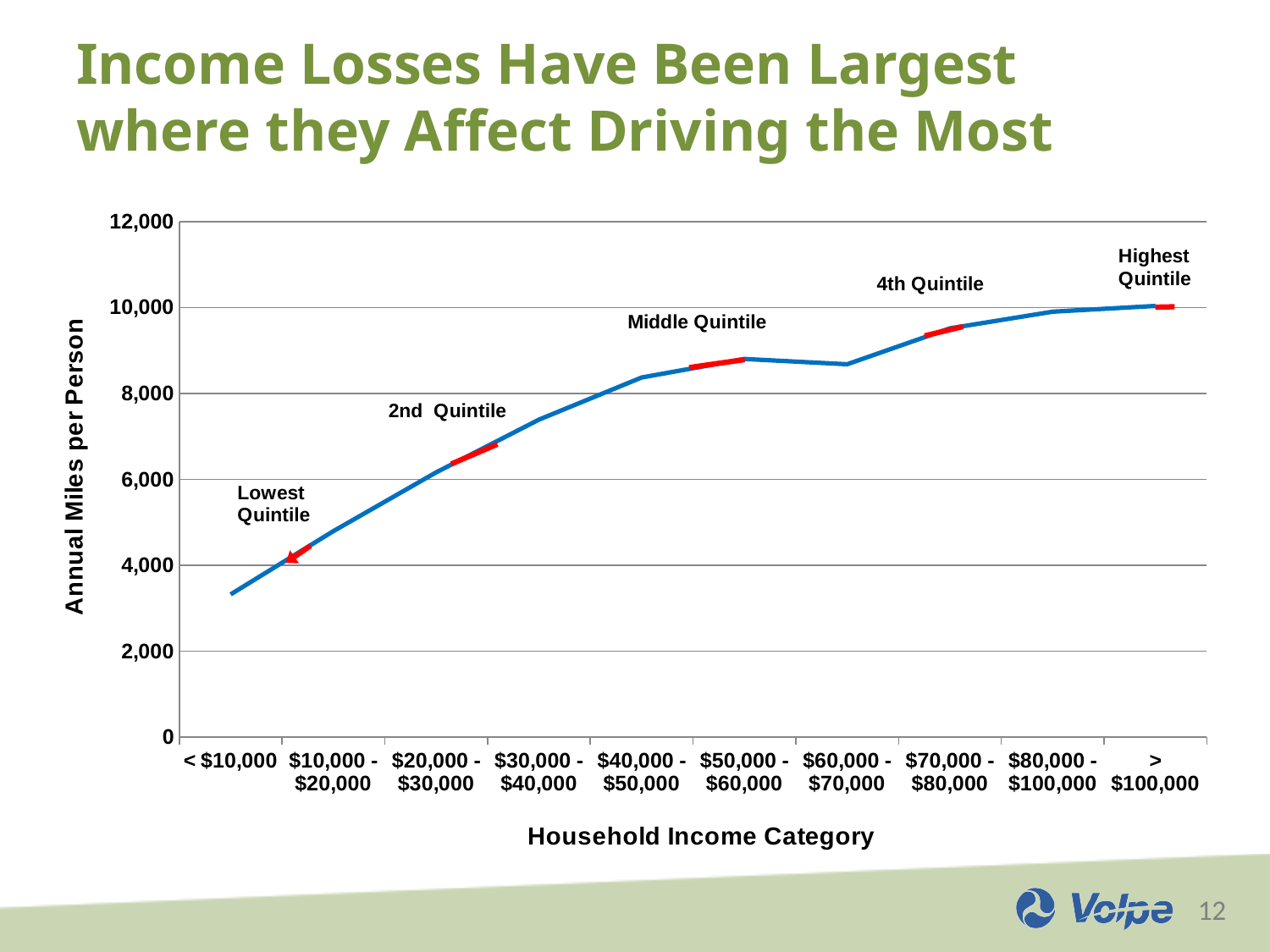
Is the value for the $70,000 - $80,000 category greater or less than 10,000? less Which has higher annual miles per person: the $20,000 - $30,000 category or the $40,000 - $50,000 category? $40,000 - $50,000 Is the value for the < $10,000 category greater or less than 4,000? less Which household income category has the lowest annual miles per person? < $10,000 Do annual miles per person generally rise or fall as household income increases along the x axis? rise What is the title of the vertical axis? Annual Miles per Person Is the value for the $10,000 - $20,000 category greater or less than 4,000? greater What kind of chart is shown on the slide? line chart How many household income categories are shown on the x axis? 10